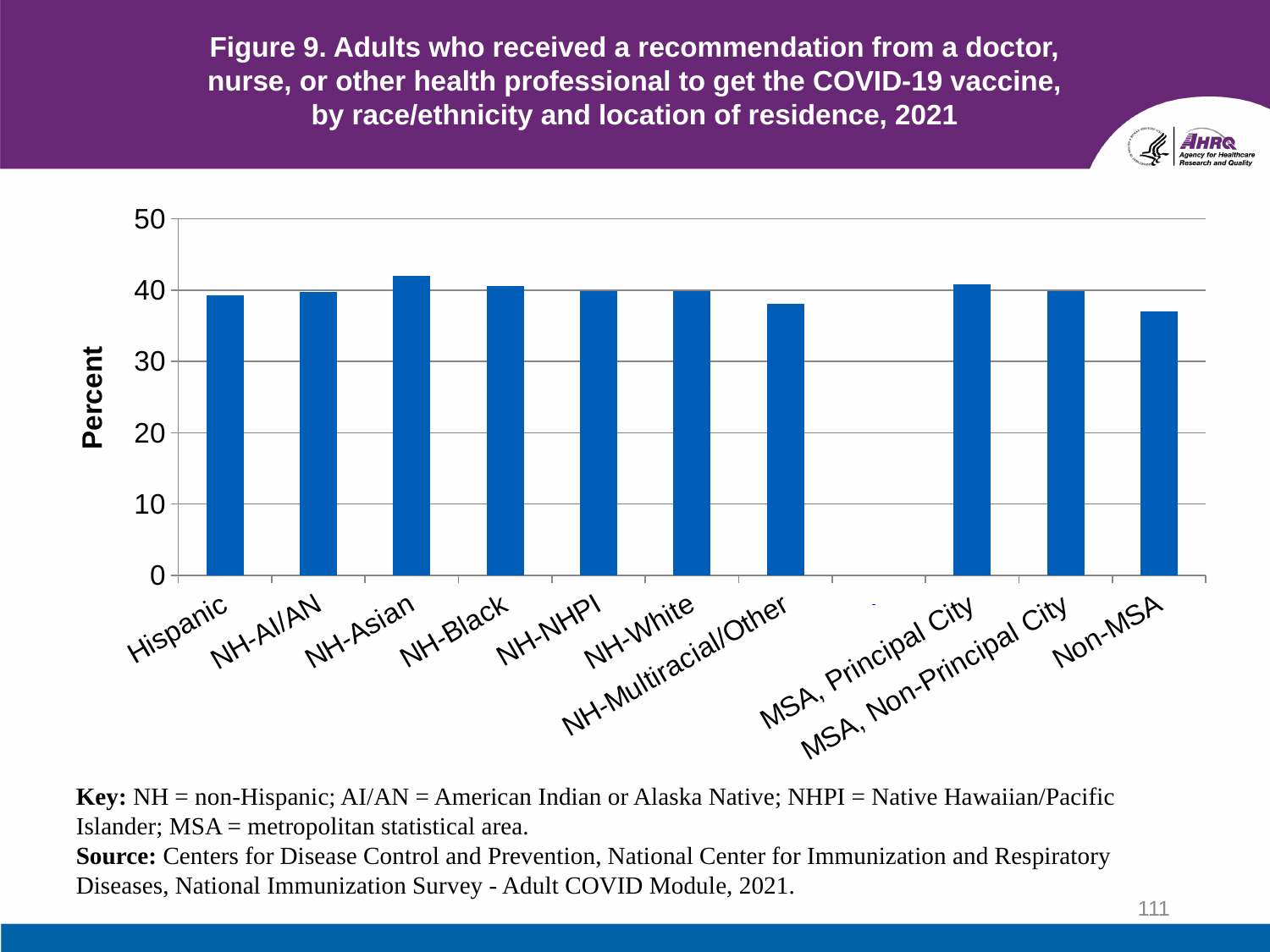
Which is larger, the value for NH-Multiracial/Other or the value for NH-Asian? NH-Asian Which category has the highest value in the chart? NH-Asian How many categories (bars) are plotted in the chart? 10 What is the label on the vertical axis of the chart? Percent Which is larger, the value for NH-Asian or the value for Non-MSA? NH-Asian Is the value for Hispanic greater or less than 40? less Is the value for Non-MSA greater or less than 40? less What kind of chart is shown on the slide? bar chart Is the value for NH-Multiracial/Other greater or less than 40? less Which category has the lowest value in the chart? Non-MSA What is the highest value shown on the vertical axis of the chart? 50